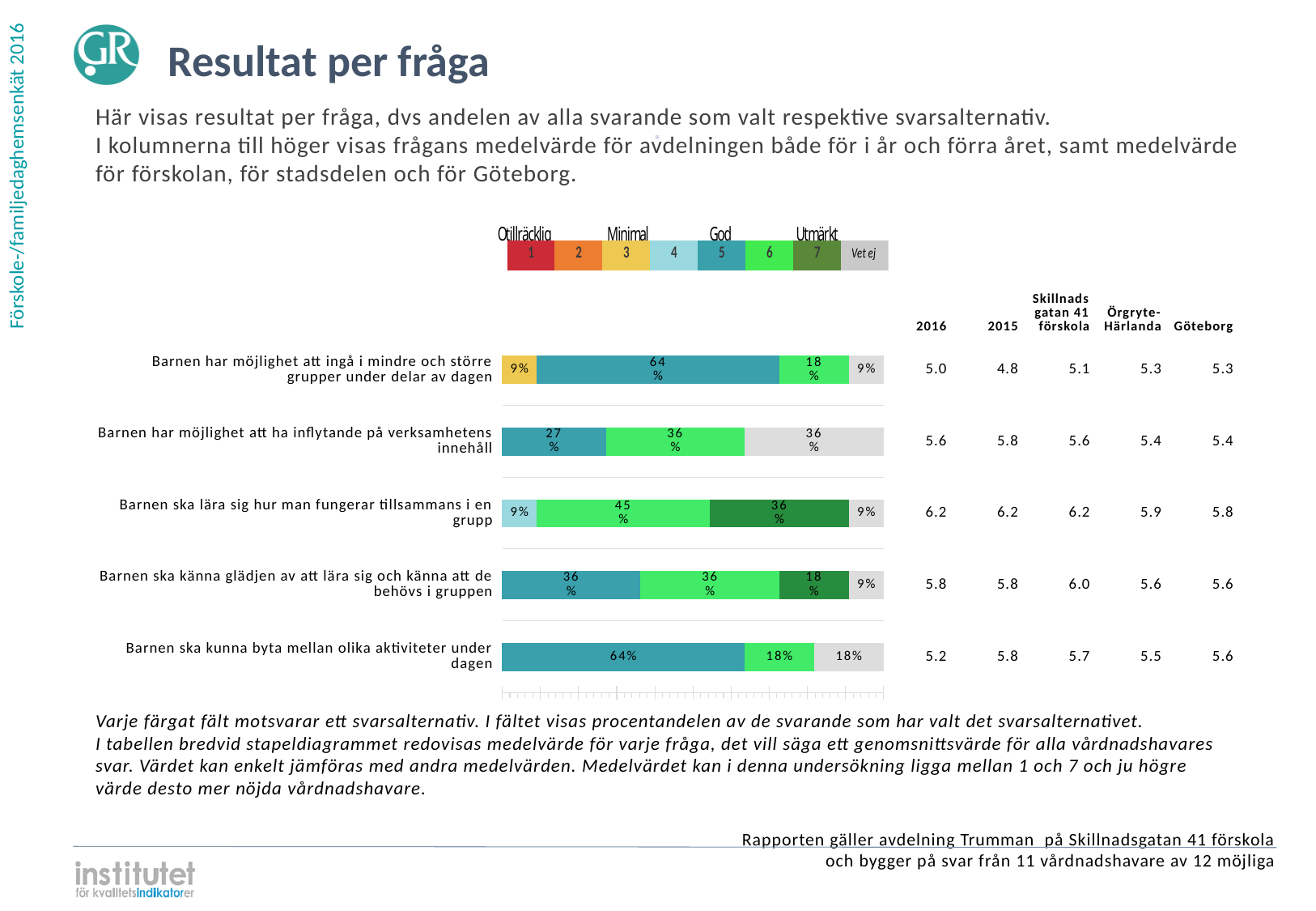
What kind of chart is used to show the results per question? Stacked bar chart What label does the legend give to the grey segment at the right end of the bars? Vet ej What share of respondents chose option 3 (Minimal) for 'Barnen har möjlighet att ingå i mindre och större grupper under delar av dagen'? 9% Is the option 6 share for 'Barnen ska lära sig hur man fungerar tillsammans i en grupp' larger or smaller than the option 6 share for 'Barnen ska känna glädjen av att lära sig och känna att de behövs i gruppen'? Larger What is the difference between the option 5 share and the option 6 share for 'Barnen ska kunna byta mellan olika aktiviteter under dagen'? 46% What share of respondents chose option 7 (Utmärkt) for 'Barnen ska lära sig hur man fungerar tillsammans i en grupp'? 36% How many questions (bars) are shown in the chart? 5 What share of respondents answered 'Vet ej' for 'Barnen har möjlighet att ha inflytande på verksamhetens innehåll'? 36% What share of respondents chose option 5 (God) for 'Barnen ska kunna byta mellan olika aktiviteter under dagen'? 64% How many answer options does the legend above the chart list? 8 What is the combined share of options 5 and 6 for 'Barnen ska känna glädjen av att lära sig och känna att de behövs i gruppen'? 72% Which question has the largest share of respondents choosing option 6 (the bright green segment)? Barnen ska lära sig hur man fungerar tillsammans i en grupp